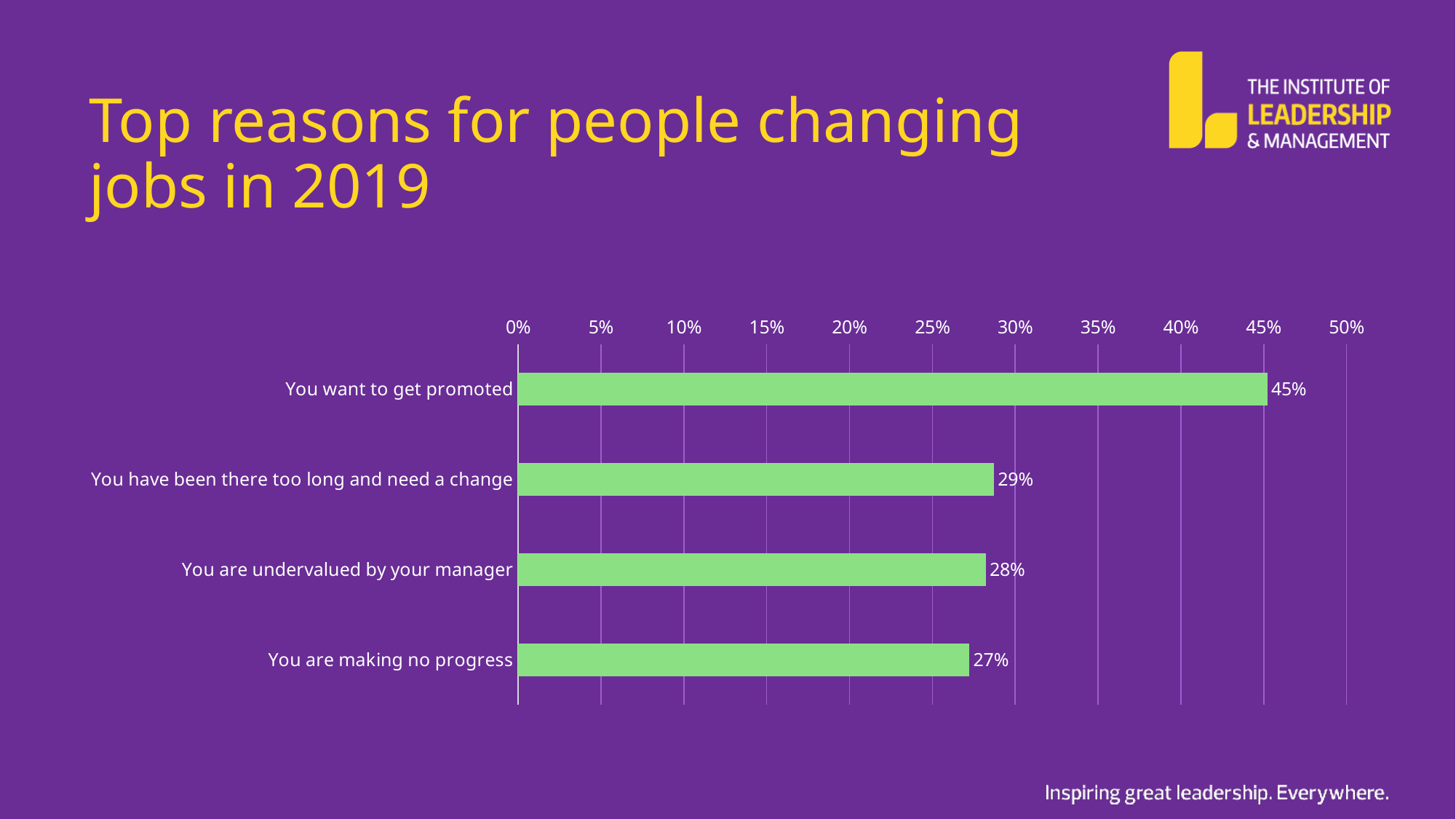
Which reason has the highest percentage? You want to get promoted What is the difference between 'You are undervalued by your manager' and 'You are making no progress'? 1% What percentage of people cited 'You want to get promoted' as a reason for changing jobs? 45% What is the value for 'You have been there too long and need a change'? 29% Which reason has the lowest percentage? You are making no progress What is the difference between 'You want to get promoted' and 'You have been there too long and need a change'? 16% Which is larger: 'You want to get promoted' or 'You are undervalued by your manager'? You want to get promoted How many reasons are shown in the chart? 4 What is the title of the slide? Top reasons for people changing jobs in 2019 What is the value for 'You are making no progress'? 27% What is the value for 'You are undervalued by your manager'? 28% What kind of chart is shown on the slide? Bar chart